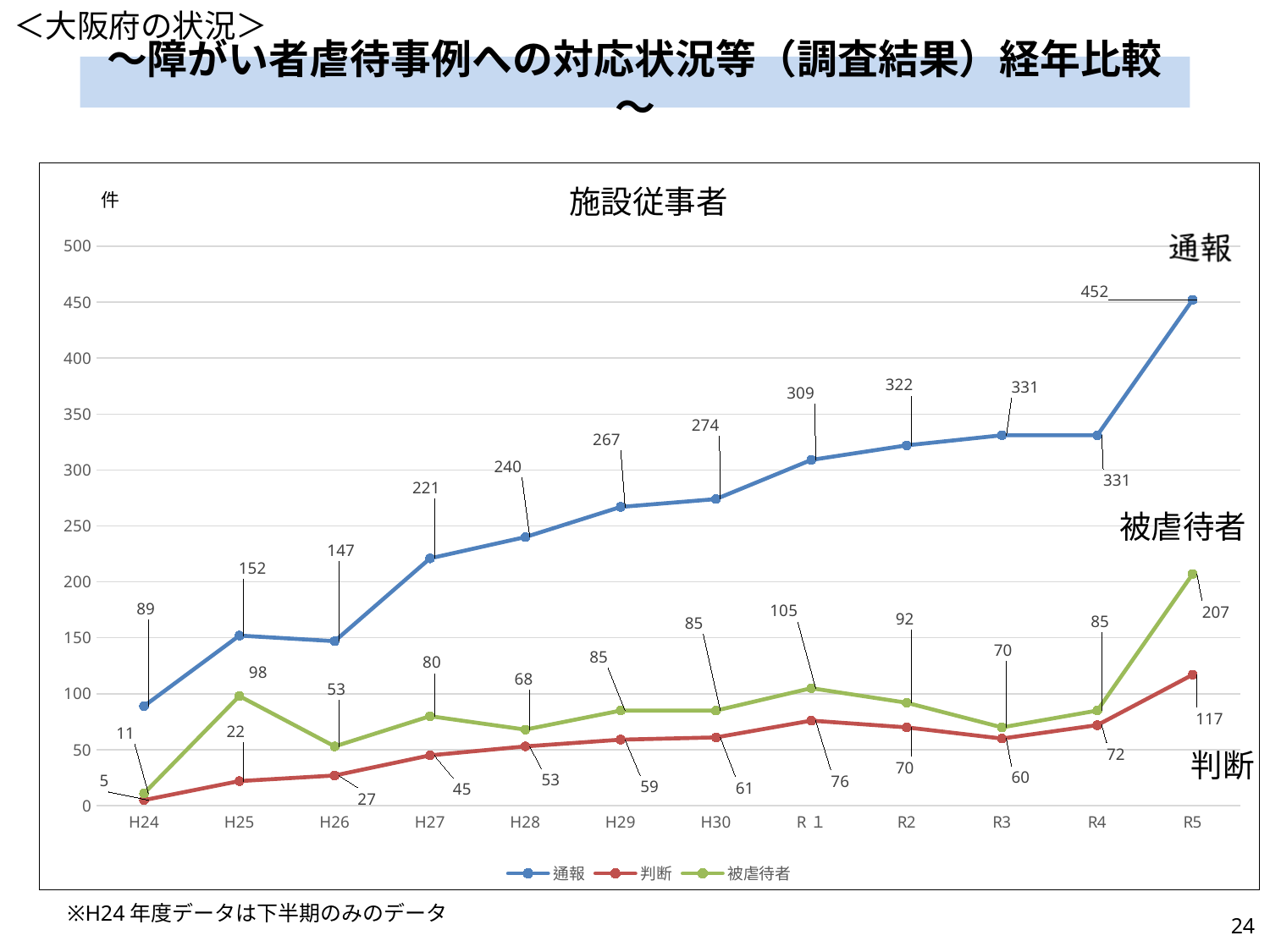
What is the value of 判断 for H27? 45 In which year is the 判断 series lowest? H24 Which is larger: 被虐待者 in H25 or 被虐待者 in H26? 被虐待者 in H25 What is the title of the chart? 施設従事者 How many years are shown on the x axis? 12 What kind of chart is this? line chart Is the value of 通報 for H27 greater or less than 200? greater In which year is the 通報 series highest? R5 What is the difference between 通報 in R5 and 通報 in R4? 121 What is the value of 被虐待者 for R1? 105 How many series does the legend list? 3 What is the value of 通報 for R5? 452